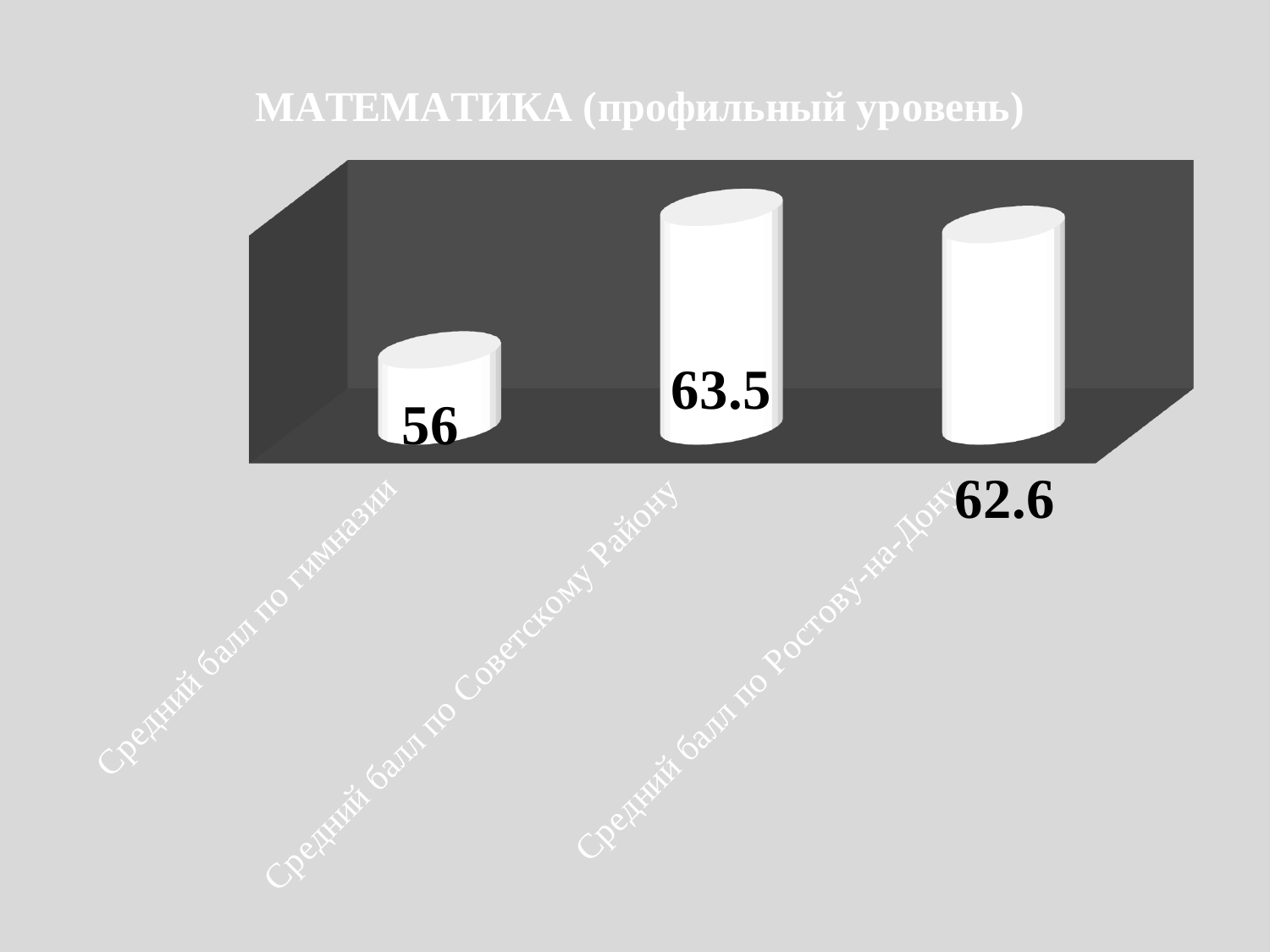
Which is larger: the average score for the gymnasium or the average score for Rostov-on-Don? Средний балл по Ростову-на-Дону How many categories are shown in the chart? 3 What is the difference between the average score for the Soviet District and the average score for the gymnasium? 7.5 What is the average score for the Soviet District (Средний балл по Советскому Району)? 63.5 Which is larger: the average score for the Soviet District or the average score for Rostov-on-Don? Средний балл по Советскому Району What is the difference between the average score for Rostov-on-Don and the average score for the gymnasium? 6.6 What is the average score for Rostov-on-Don (Средний балл по Ростову-на-Дону)? 62.6 What is the average score for the gymnasium (Средний балл по гимназии)? 56 Which category has the lowest average score? Средний балл по гимназии Which category has the highest average score? Средний балл по Советскому Району What kind of chart is shown on the slide? Bar chart What is the title of the chart? МАТЕМАТИКА (профильный уровень)